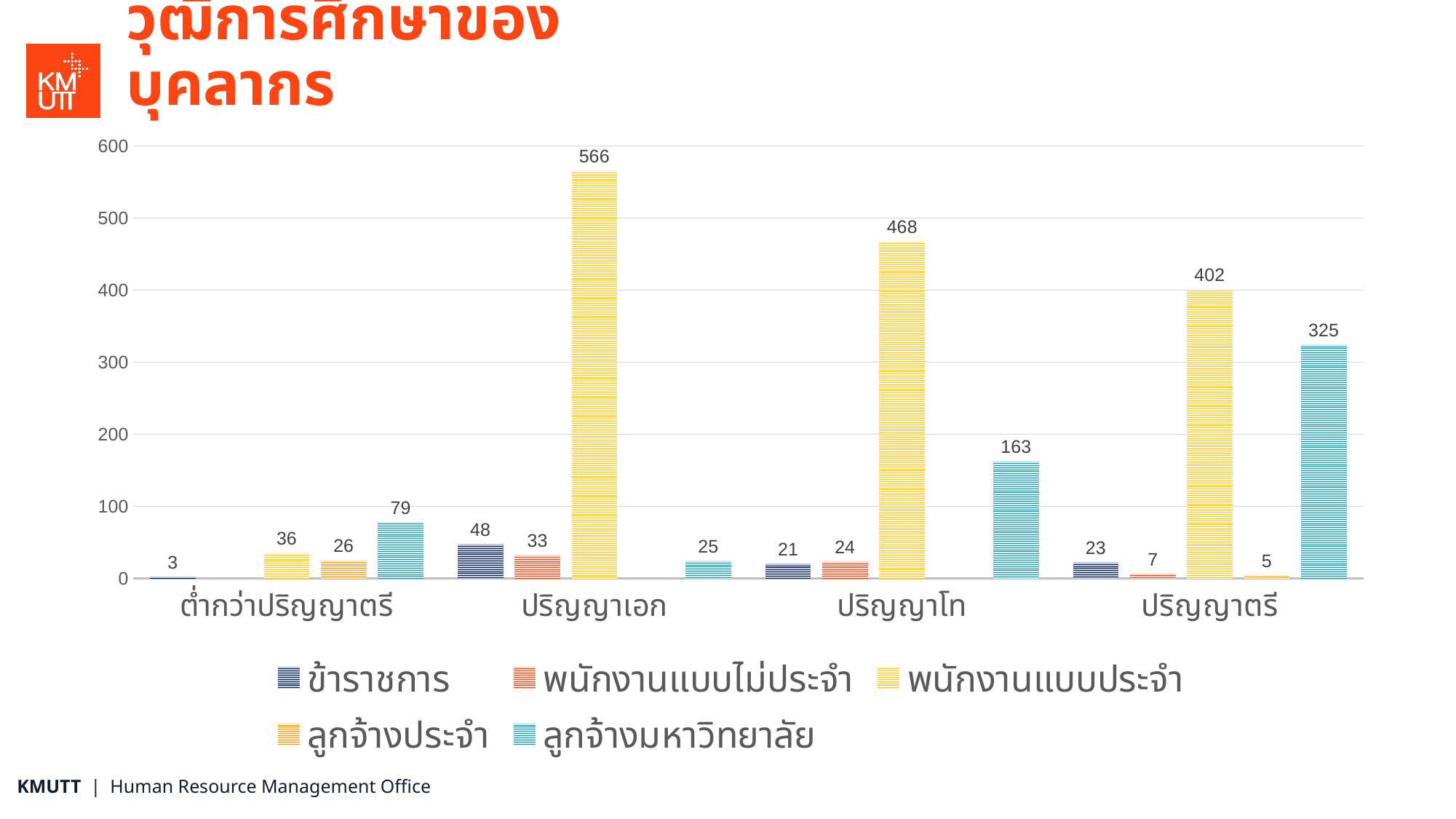
Is the value for ลูกจ้างมหาวิทยาลัย in ปริญญาโท greater or less than 200? less What is the difference between the พนักงานแบบประจำ values for ปริญญาโท and ปริญญาตรี? 66 What is the value for พนักงานแบบประจำ in the ปริญญาเอก category? 566 Which is larger: ข้าราชการ in ปริญญาเอก or ข้าราชการ in ปริญญาโท? ปริญญาเอก How many series does the legend list? 5 What type of chart is shown on the slide? bar chart How many education-level categories are shown on the x axis? 4 What is the value for ลูกจ้างมหาวิทยาลัย in the ปริญญาตรี category? 325 Which category has the lowest value for ลูกจ้างมหาวิทยาลัย? ปริญญาเอก What is the title of the chart on the slide? วุฒิการศึกษาของบุคลากร What is the value for ข้าราชการ in the ต่ำกว่าปริญญาตรี category? 3 Which category has the highest value for พนักงานแบบประจำ? ปริญญาเอก